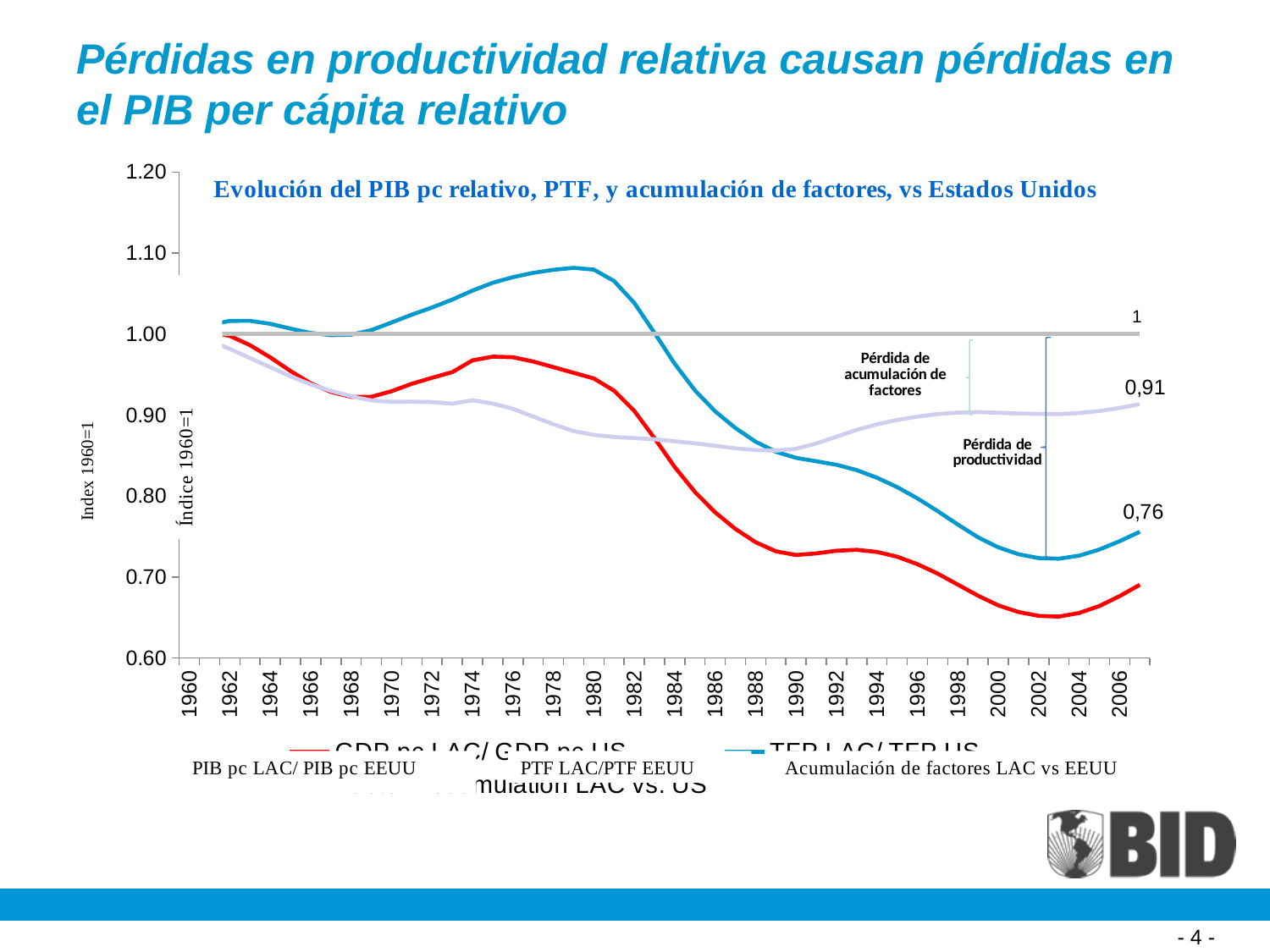
Is the value of PIB pc LAC/ PIB pc EEUU in 2002 greater or less than 0.70? less What is the difference between the reference line value (1) and the final Acumulación de factores value (0,91)? 0,09 What is the title of the chart? Evolución del PIB pc relativo, PTF, y acumulación de factores, vs Estados Unidos Is the value of PTF LAC/PTF EEUU in 1980 greater or less than 1.00? greater Does the PIB pc LAC/ PIB pc EEUU line generally rise or fall from 1960 to 2002? Fall What value is labelled on the horizontal reference line? 1 What kind of chart is shown on the slide? Line chart What value is labelled at the end of the Acumulación de factores LAC vs EEUU line? 0,91 What value is labelled at the end of the PTF LAC/PTF EEUU line? 0,76 What is the difference between the final Acumulación de factores value (0,91) and the final PTF LAC/PTF EEUU value (0,76)? 0,15 In 2006, which series is higher: PTF LAC/PTF EEUU or PIB pc LAC/ PIB pc EEUU? PTF LAC/PTF EEUU How many series does the chart legend list? 3